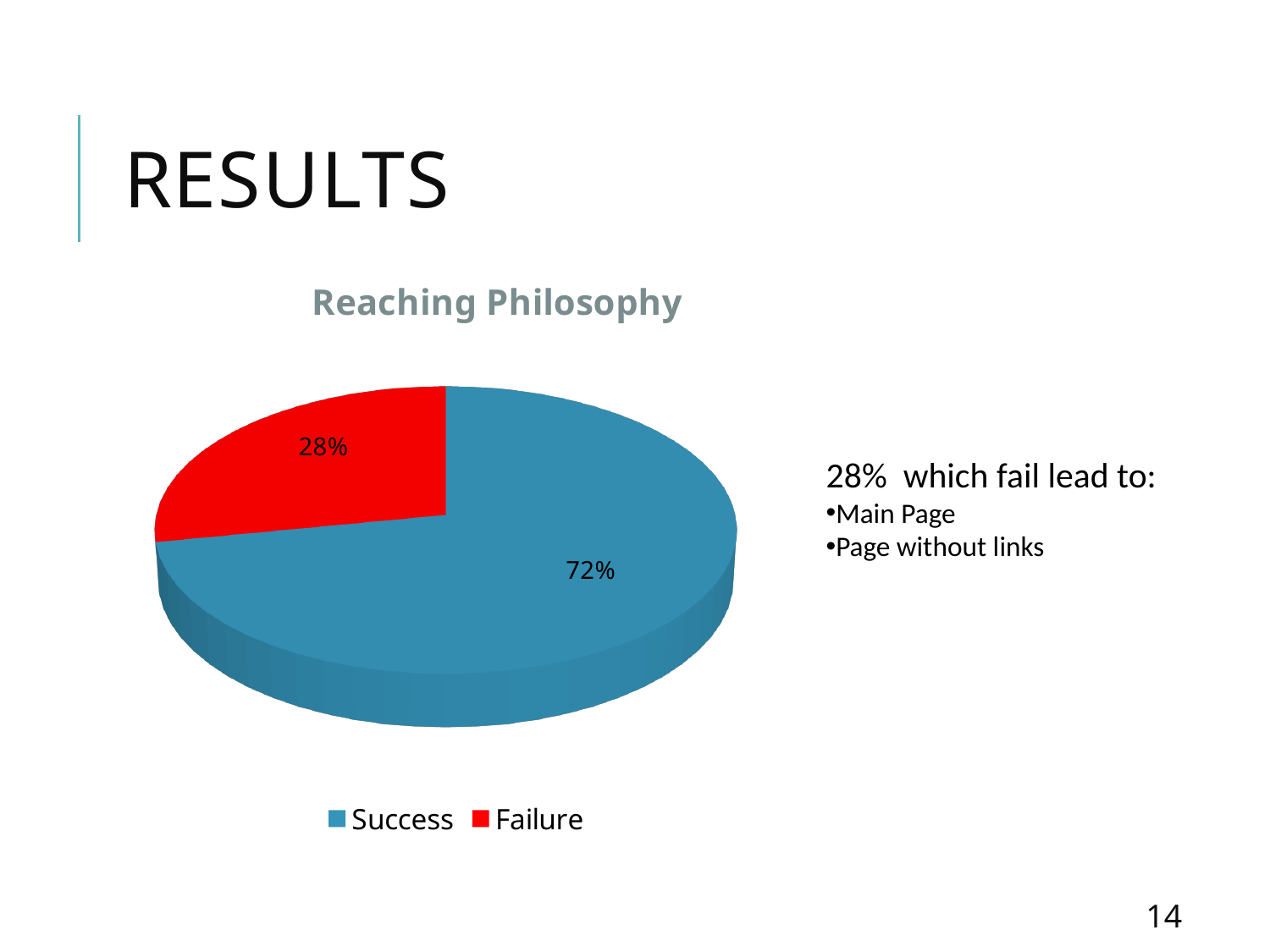
What percentage of the pie is labelled Failure? 28% What colour is the Failure slice? red Which category has the largest share of the pie? Success How many entries does the legend list? 2 Which category has the smallest share of the pie? Failure What percentage of the pie is labelled Success? 72% Which is larger, the Success slice or the Failure slice? Success How many slices does the pie chart have? 2 What share of the pie does the Success slice represent? 72% What type of chart is shown on the slide? pie chart What is the difference in percentage points between Success and Failure? 44 What is the title of the chart? Reaching Philosophy